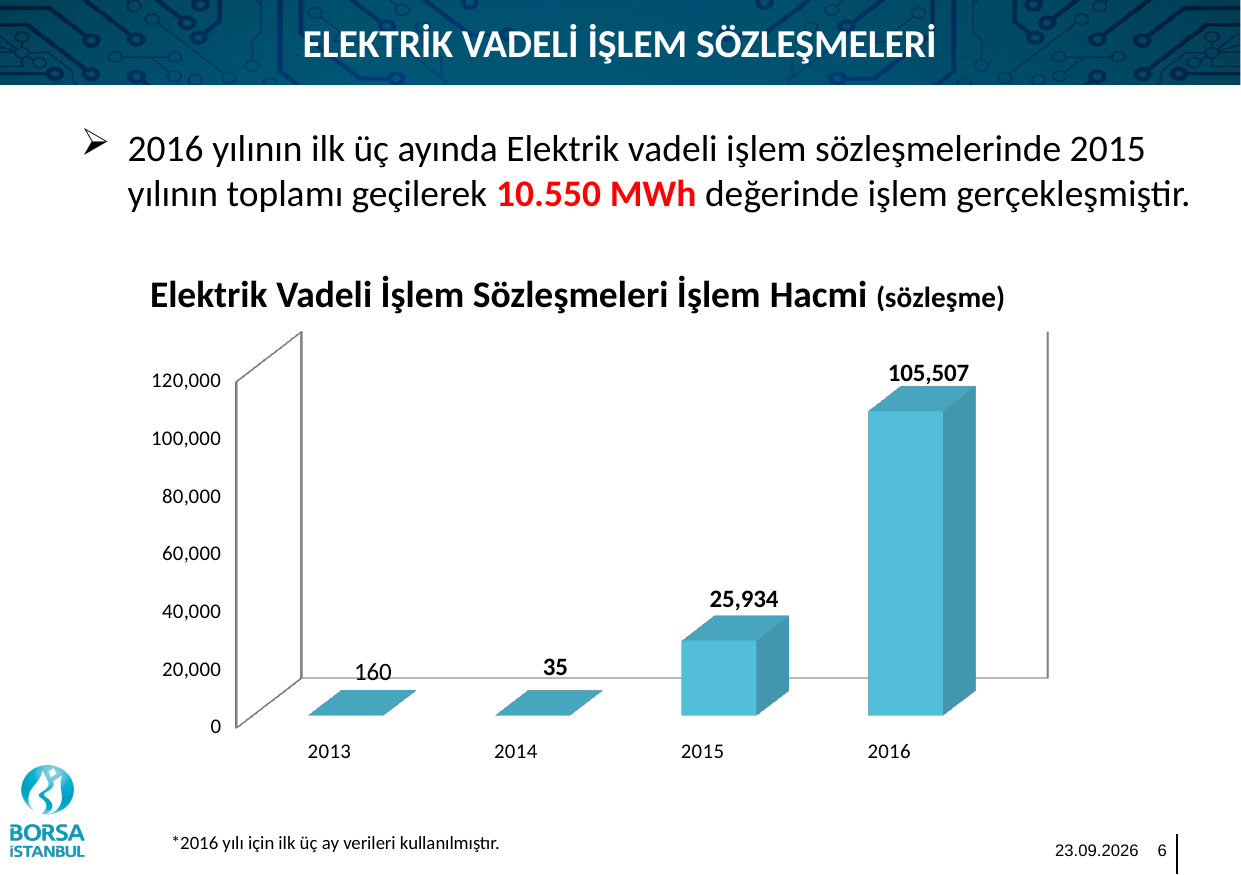
What is the difference between the values for 2016 and 2015? 79,573 What is the value for 2016 in the chart? 105,507 Which year has the highest value in the chart? 2016 What is the difference between the values for 2013 and 2014? 125 What is the value for 2014 in the chart? 35 Which year has the lowest value in the chart? 2014 Which is larger, the value for 2013 or the value for 2014? 2013 How many years are shown on the x axis of the chart? 4 What is the value for 2015 in the chart? 25,934 What type of chart is shown on the slide? bar chart Is the value for 2016 greater or less than 100,000? greater What is the value for 2013 in the chart? 160